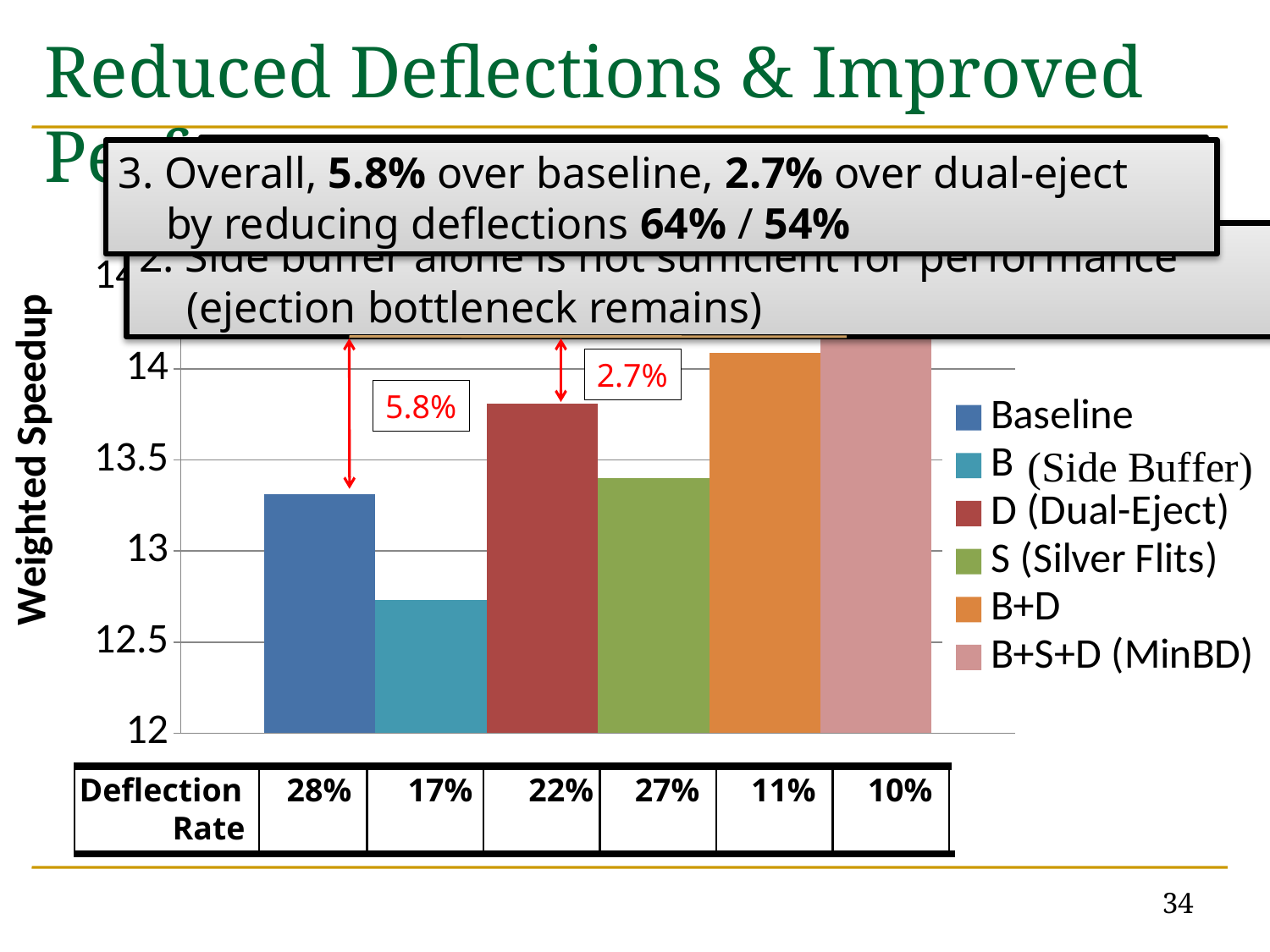
What is the deflection rate shown for the Baseline bar in the table below the chart? 28% Which configuration has the highest weighted speedup? B+S+D (MinBD) Which has a higher weighted speedup, D (Dual-Eject) or S (Silver Flits)? D (Dual-Eject) How many bars are plotted in the chart? 6 Is the weighted speedup for D (Dual-Eject) greater or less than 13.5? greater Is the weighted speedup for B (Side Buffer) greater or less than 13? less Which configuration has the lowest weighted speedup? B (Side Buffer) What kind of chart is shown on the slide? bar chart What is the label on the vertical axis of the chart? Weighted Speedup How many entries does the chart legend list? 6 Is the weighted speedup for Baseline greater or less than 13.5? less